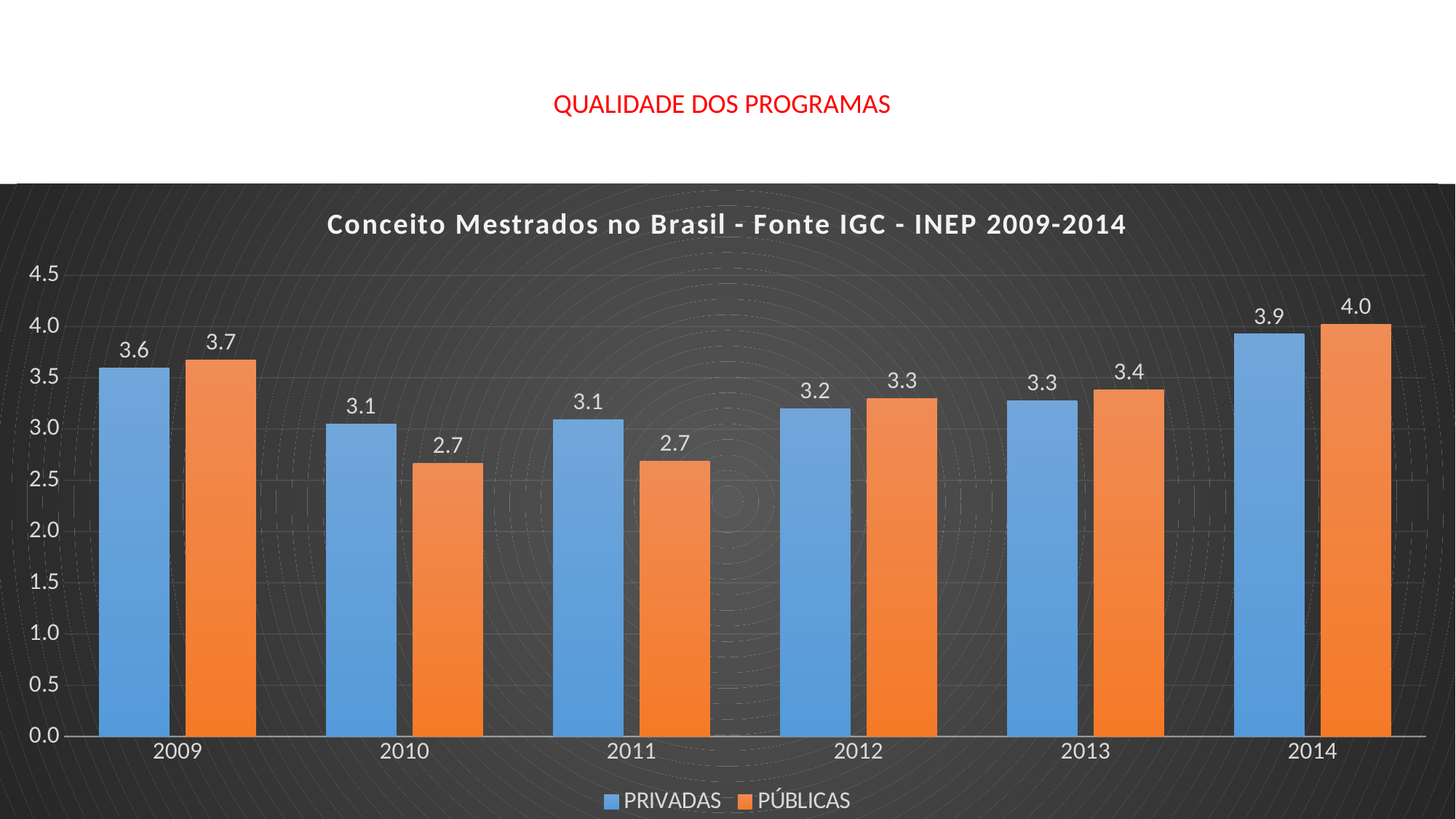
How many years are shown on the x axis? 6 What is the value for PRIVADAS in 2012? 3.2 What kind of chart is shown? Bar chart In which year is the PRIVADAS value lowest? 2010 and 2011 What is the value for PRIVADAS in 2009? 3.6 What is the value for PÚBLICAS in 2014? 4.0 What is the value for PÚBLICAS in 2010? 2.7 In which year is the PÚBLICAS value highest? 2014 What is the difference between the PÚBLICAS and PRIVADAS values in 2011? 0.4 What is the title of the chart? Conceito Mestrados no Brasil - Fonte IGC - INEP 2009-2014 How many series does the legend list? 2 Which series has the larger value in 2010, PRIVADAS or PÚBLICAS? PRIVADAS